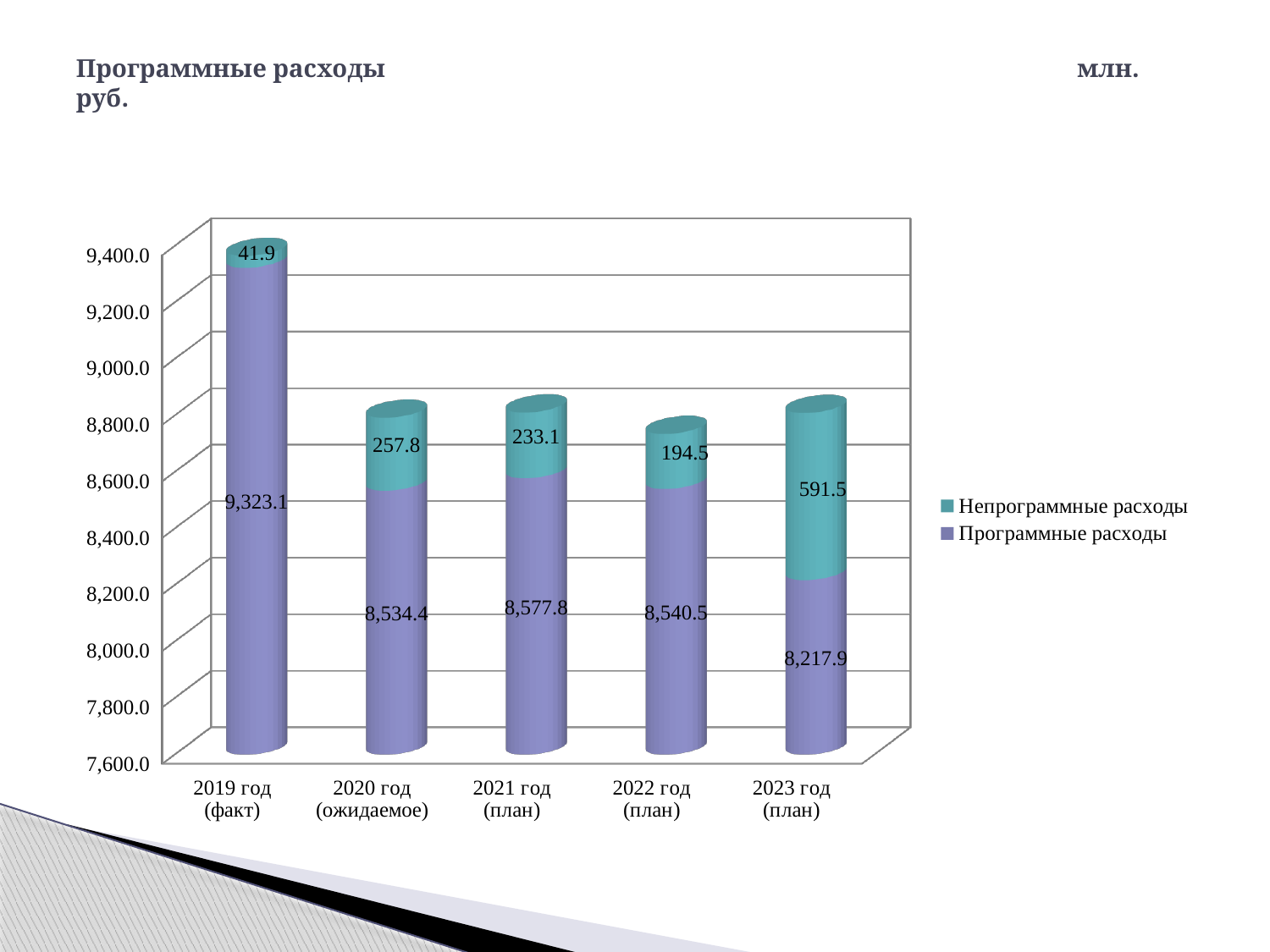
What is the value of Программные расходы for 2021 год (план)? 8,577.8 How many years are shown on the x axis? 5 Which year has the lowest value of Программные расходы? 2023 год (план) What is the value of Непрограммные расходы for 2023 год (план)? 591.5 What is the value of Программные расходы for 2019 год (факт)? 9,323.1 What kind of chart is shown on the slide? Stacked bar chart Which is larger: Непрограммные расходы in 2020 год (ожидаемое) or in 2022 год (план)? 2020 год (ожидаемое) What is the total of the stacked bar for 2022 год (план)? 8,735.0 What is the difference between Программные расходы in 2019 год (факт) and 2020 год (ожидаемое)? 788.7 Which colour represents Непрограммные расходы in the legend? Teal Which year has the highest value of Непрограммные расходы? 2023 год (план) How many series does the legend list? 2